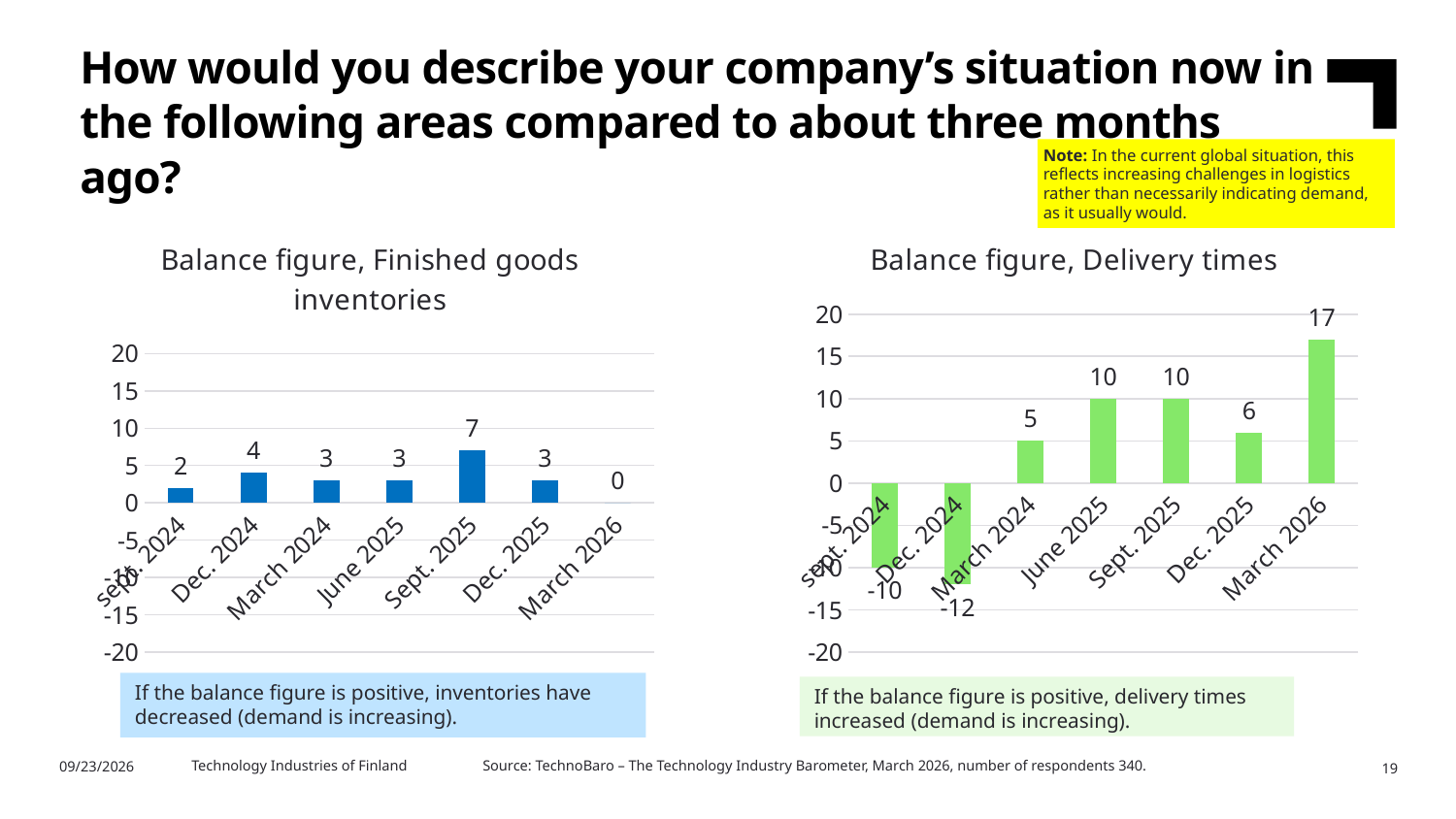
What kind of chart is the 'Balance figure, Delivery times' chart? Bar chart In the 'Balance figure, Delivery times' chart, what is the value for Dec. 2024? -12 In the 'Balance figure, Delivery times' chart, what is the difference between the values for March 2026 and Sept. 2024? 27 In the 'Balance figure, Finished goods inventories' chart, which period has the highest value? Sept. 2025 In the 'Balance figure, Finished goods inventories' chart, how many periods are shown on the x axis? 7 In the 'Balance figure, Finished goods inventories' chart, what is the difference between the values for Sept. 2025 and Dec. 2025? 4 In the 'Balance figure, Finished goods inventories' chart, what is the value for Sept. 2025? 7 In the 'Balance figure, Delivery times' chart, what is the value for March 2026? 17 In the 'Balance figure, Delivery times' chart, is the value for Sept. 2024 greater or less than 0? less In the 'Balance figure, Delivery times' chart, which period has the lowest value? Dec. 2024 In the 'Balance figure, Finished goods inventories' chart, what is the value for March 2026? 0 In the 'Balance figure, Delivery times' chart, which is larger, the value for June 2025 or the value for Dec. 2025? June 2025